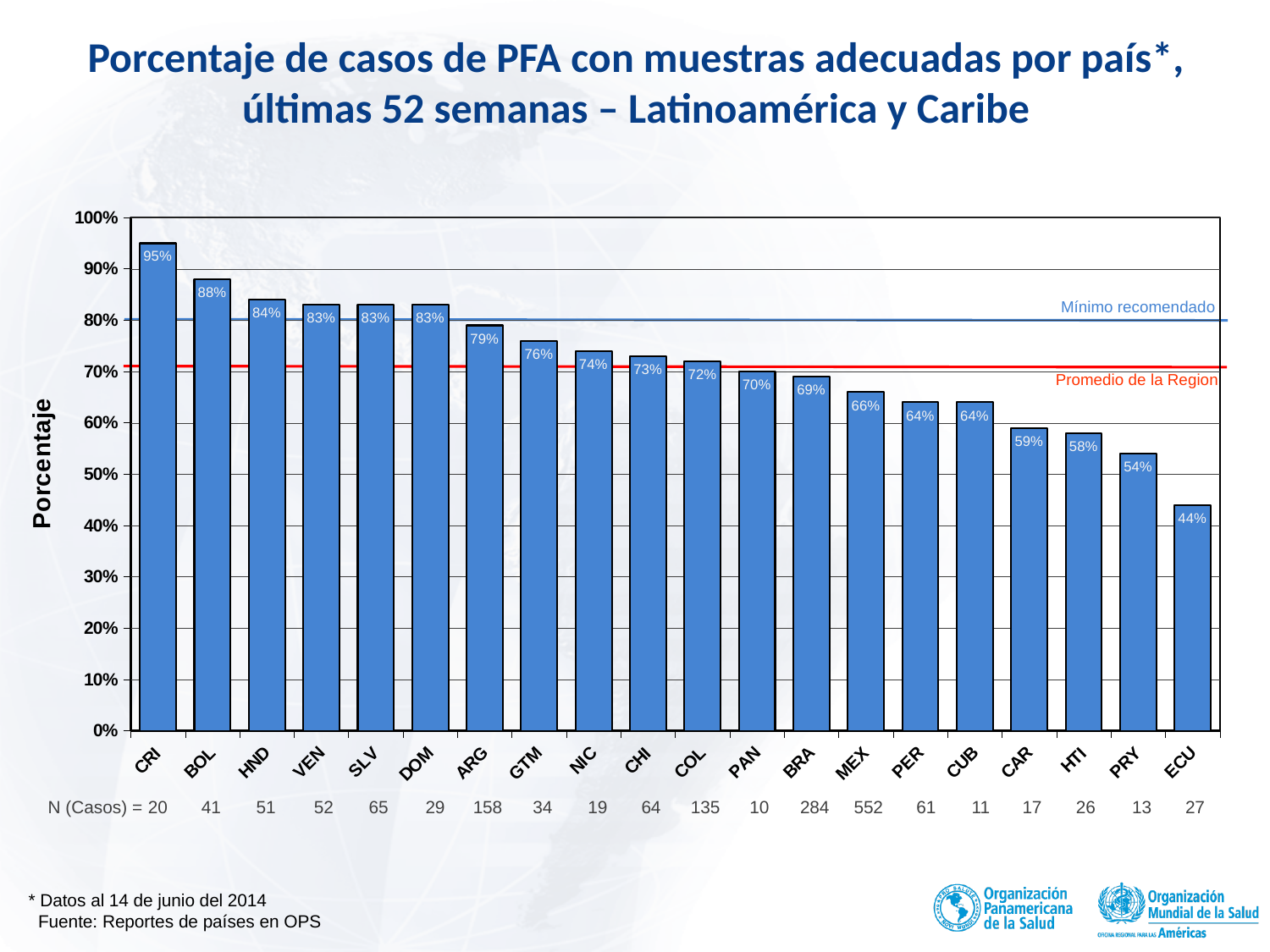
What is the value for MEX? 66% How many countries are shown on the x axis? 20 What is the value for CRI? 95% Which country has the lowest percentage? ECU What kind of chart is shown on the slide? bar chart Is the value for BRA greater or less than 80%? less What is the difference between the values for BOL and HTI? 30% Which country has the highest percentage? CRI Do the values rise or fall from left to right along the x axis? fall Which is larger, the value for ARG or the value for PAN? ARG What is the value for GTM? 76% What is the label of the blue horizontal reference line? Mínimo recomendado